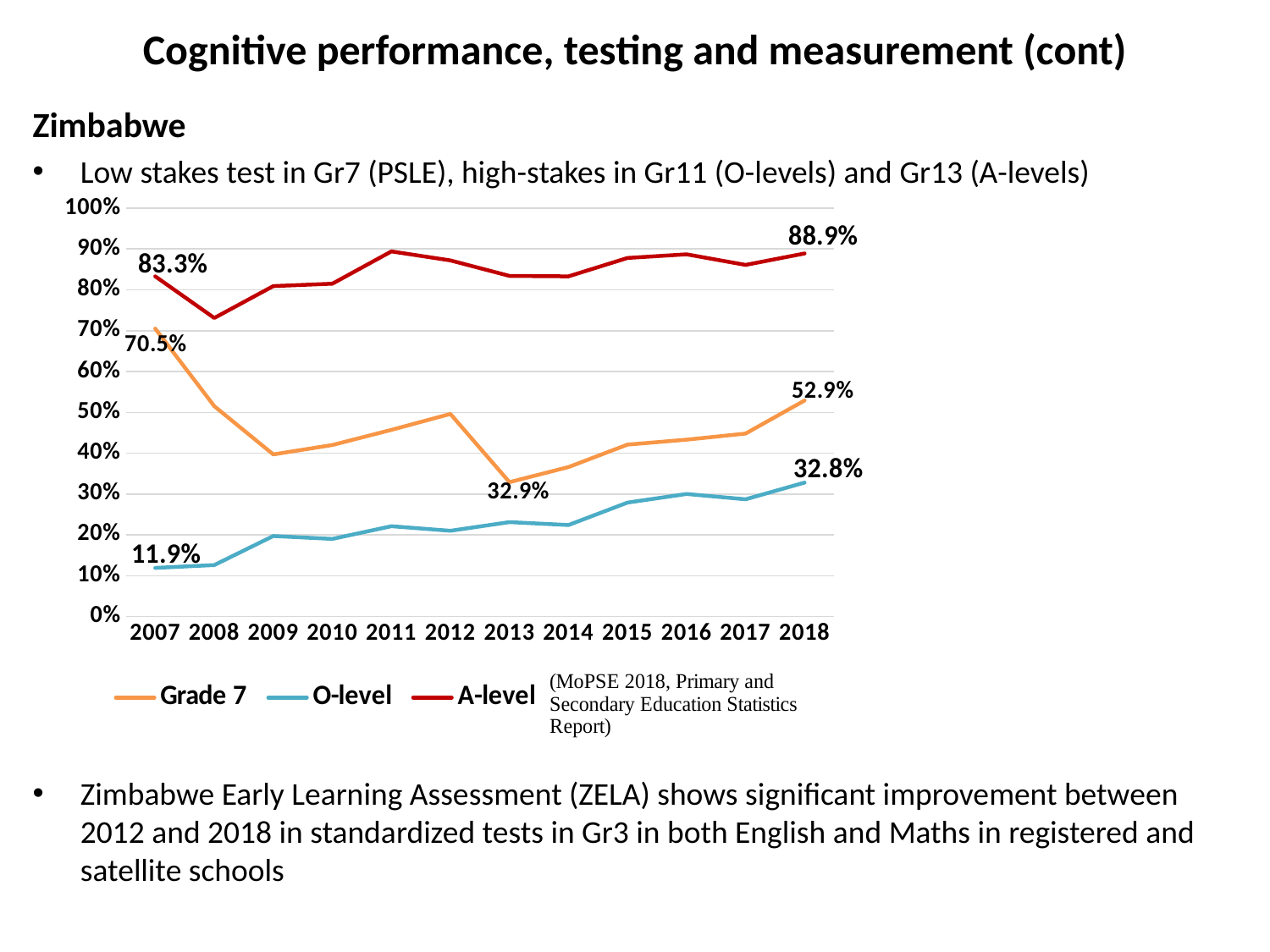
Which series has the highest value in 2018? A-level What is the Grade 7 value in 2007? 70.5% What is the Grade 7 value in 2013? 32.9% What is the O-level value in 2007? 11.9% Which series has the lowest value in 2007? O-level How many years are shown on the x axis of the chart? 12 What is the A-level value in 2018? 88.9% What is the difference between the A-level value in 2018 and the A-level value in 2007? 5.6% Is the Grade 7 value in 2018 larger or smaller than the O-level value in 2018? larger Is the A-level value in 2008 greater or less than 80%? less How many series does the chart legend list? 3 What type of chart is shown on the slide? line chart